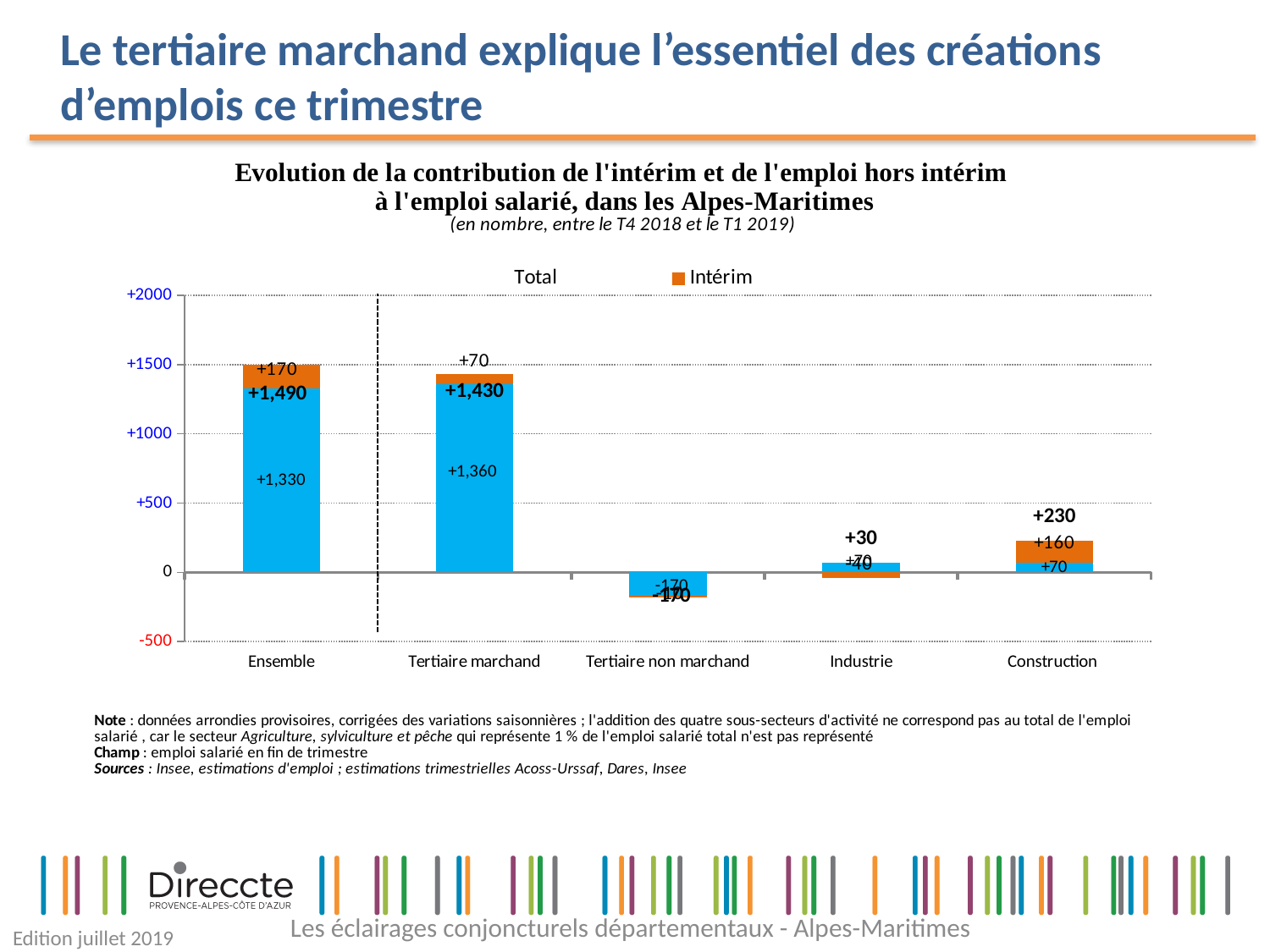
How many categories are shown on the x axis of the chart? 5 Which category has the lowest total value? Tertiaire non marchand What is the total value shown for Ensemble? +1,490 What kind of chart is shown on the slide? bar chart What is the difference between the total for Ensemble and the total for Tertiaire marchand? 60 What is the total value shown for Tertiaire marchand? +1,430 Is the total value for Ensemble greater or less than +1000? greater What is the Intérim value shown for Construction? +160 What is the total value shown for Construction? +230 How many entries does the chart's legend list? 2 What is the value of the blue (hors intérim) segment for Tertiaire marchand? +1,360 Which has the larger Intérim value, Ensemble or Construction? Ensemble